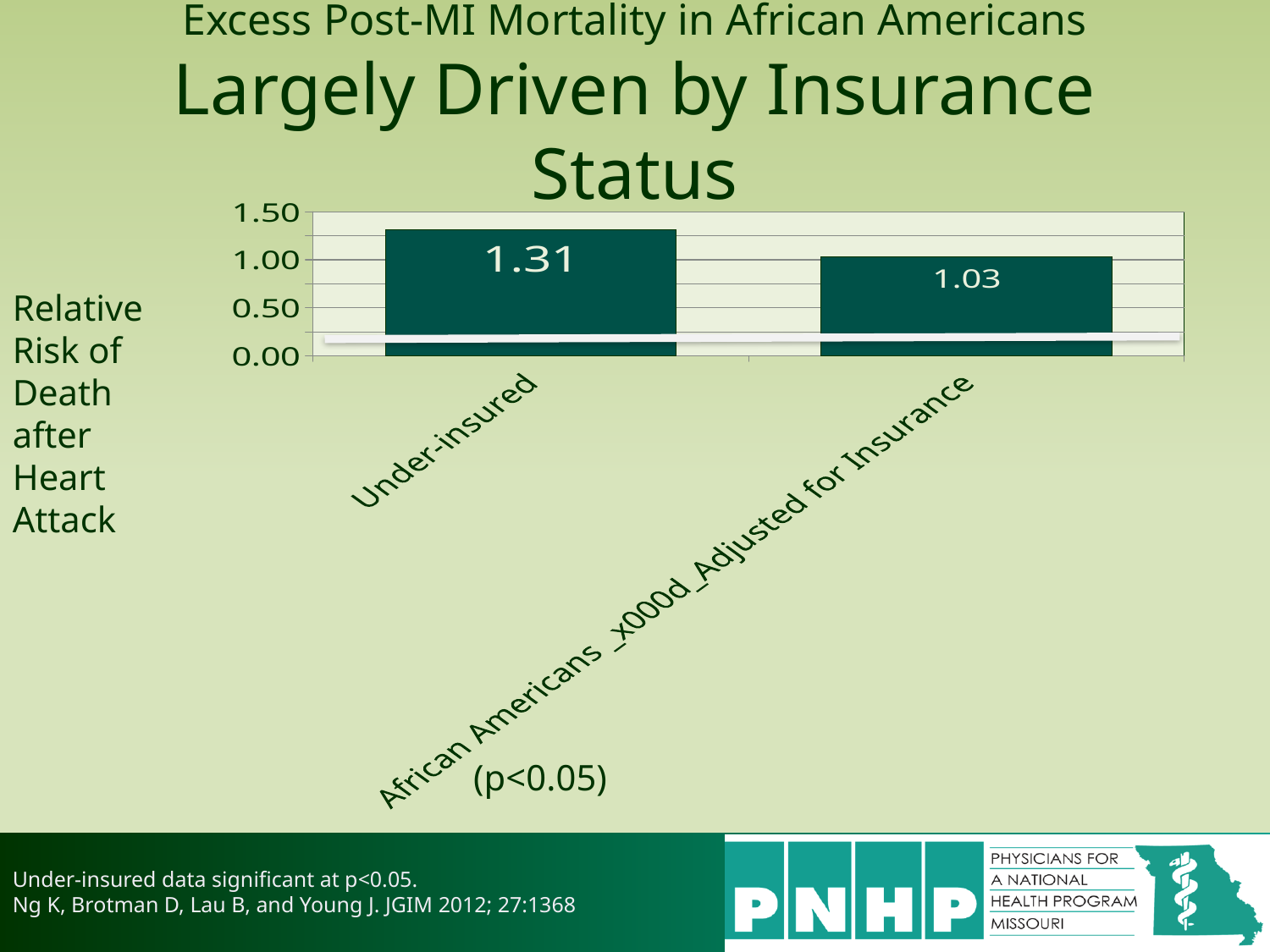
Is the value for the Under-insured group greater or less than 1.00? greater Which category has the lower relative risk of death after heart attack? African Americans Adjusted for Insurance What kind of chart is shown on the slide? bar chart How many categories are plotted in the chart? 2 What quantity does the vertical axis of the chart represent, according to the label on the left of the slide? Relative Risk of Death after Heart Attack Is the relative risk for the Under-insured group larger or smaller than that for African Americans adjusted for insurance? larger Is the value for African Americans adjusted for insurance greater or less than 1.50? less What is the difference between the relative risk for the Under-insured group and for African Americans adjusted for insurance? 0.28 What is the relative risk of death after heart attack for the Under-insured group? 1.31 Which category has the higher relative risk of death after heart attack? Under-insured What is the relative risk of death after heart attack for African Americans adjusted for insurance? 1.03 What is the highest value shown on the vertical axis of the chart? 1.50